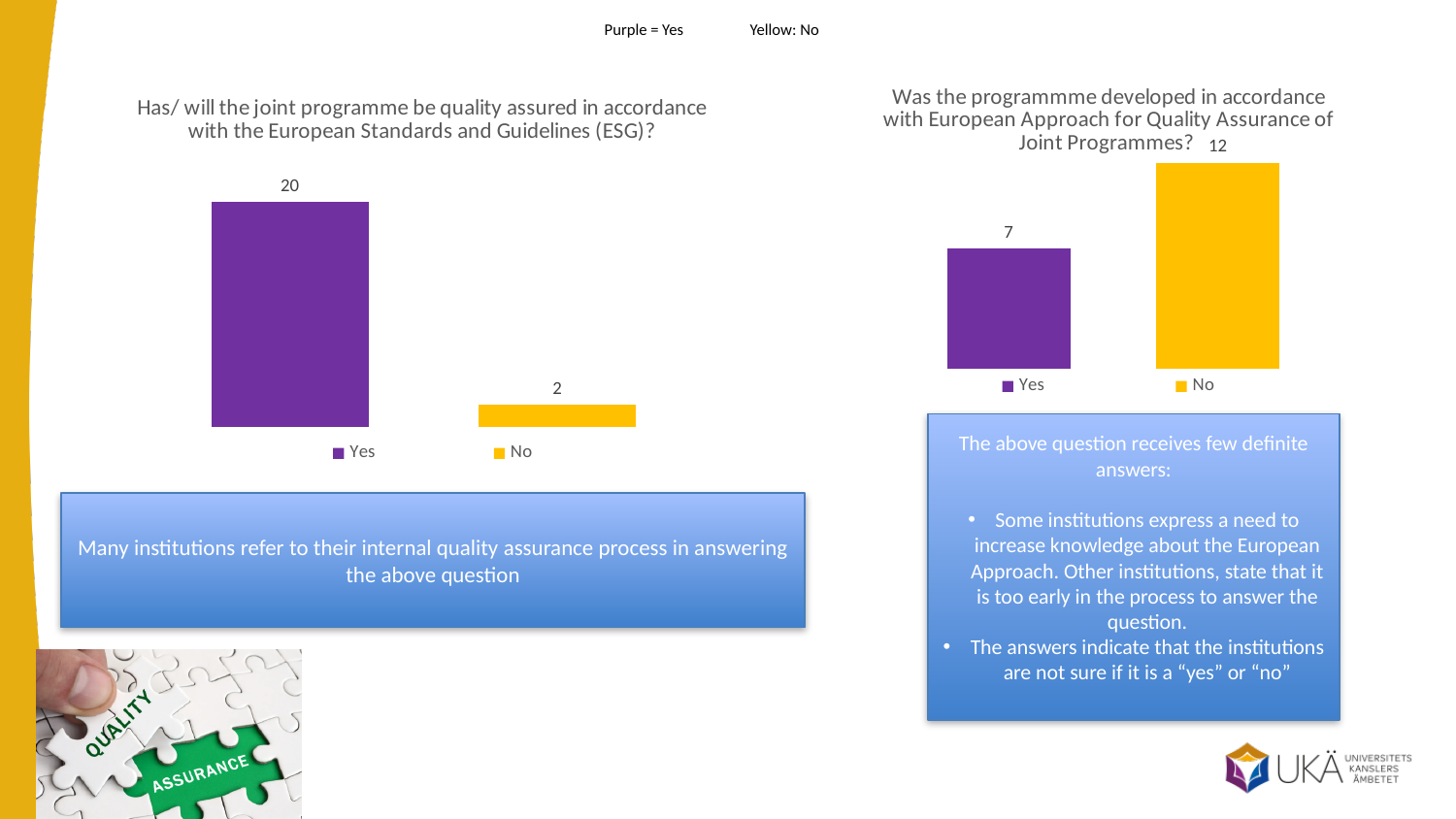
In the right chart (European Approach), what is the difference between the No and Yes values? 5 In the right chart (European Approach), what is the value for Yes? 7 In the right chart (European Approach), what is the value for No? 12 What kind of chart is the right chart (European Approach)? Bar chart In the left chart (ESG quality assurance), what is the difference between the Yes and No values? 18 In the right chart (European Approach), which is larger, Yes or No? No In the left chart (ESG quality assurance), what is the value for No? 2 In the left chart (ESG quality assurance), what colour is the Yes bar? Purple In the left chart (ESG quality assurance), what is the value for Yes? 20 How many categories are shown in the left chart (ESG quality assurance)? 2 In the right chart (European Approach), which category has the lowest value? Yes In the left chart (ESG quality assurance), which category has the highest value? Yes